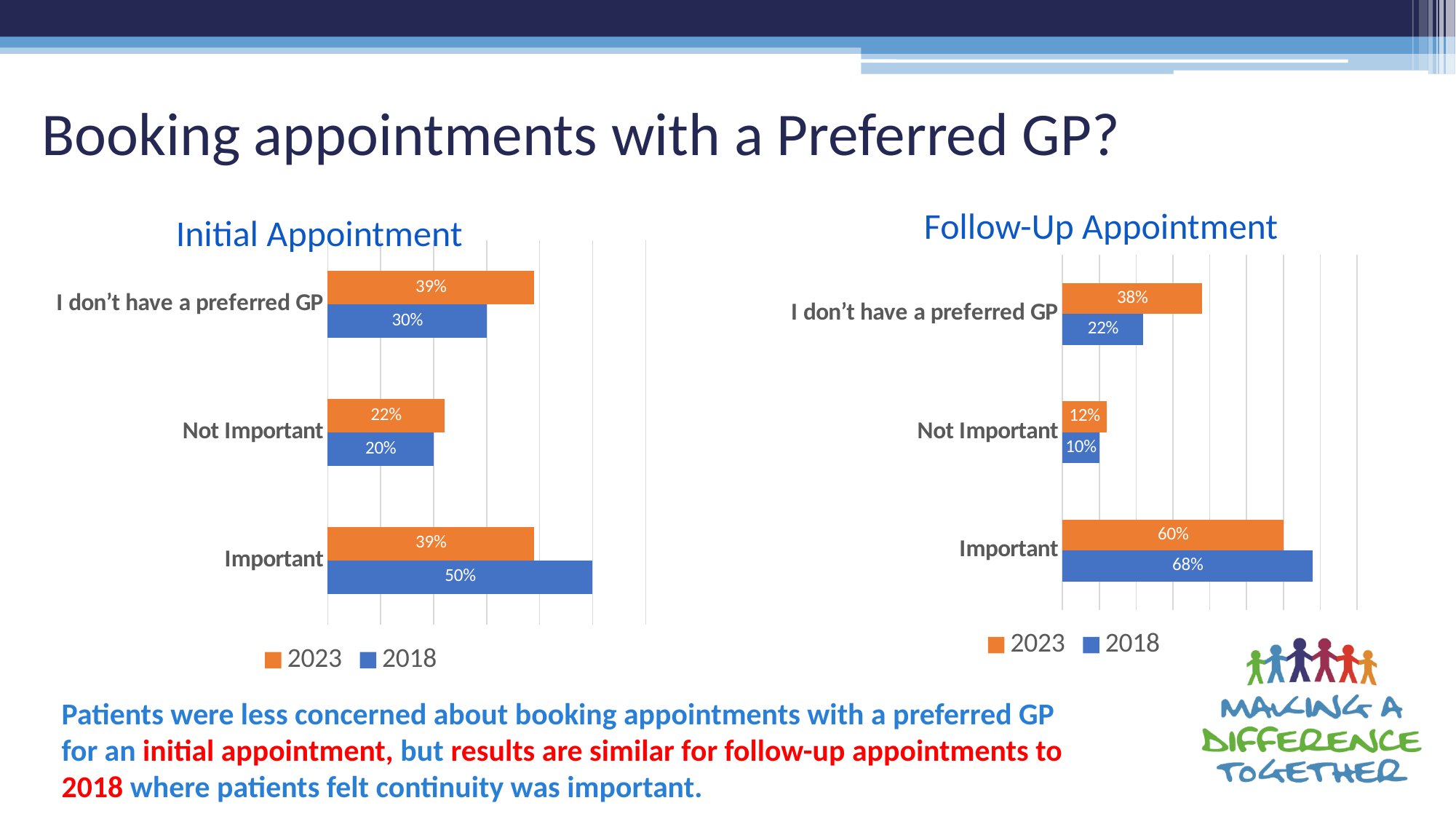
How many series does the legend of the Initial Appointment chart list? 2 How many categories does the Follow-Up Appointment chart show? 3 In the Initial Appointment chart, what is the 2023 value for "Important"? 39% In the Follow-Up Appointment chart, which colour represents 2023? Orange In the Initial Appointment chart, which is larger for "I don't have a preferred GP": the 2023 value or the 2018 value? 2023 In the Follow-Up Appointment chart, what is the difference between the 2018 and 2023 values for "Important"? 8% In the Initial Appointment chart, what is the 2018 value for "Important"? 50% In the Follow-Up Appointment chart, what is the 2023 value for "Not Important"? 12% In the Follow-Up Appointment chart, which category has the highest 2018 value? Important What kind of chart is the Initial Appointment chart? Bar chart In the Follow-Up Appointment chart, what is the 2018 value for "I don't have a preferred GP"? 22% In the Initial Appointment chart, which category has the lowest 2018 value? Not Important